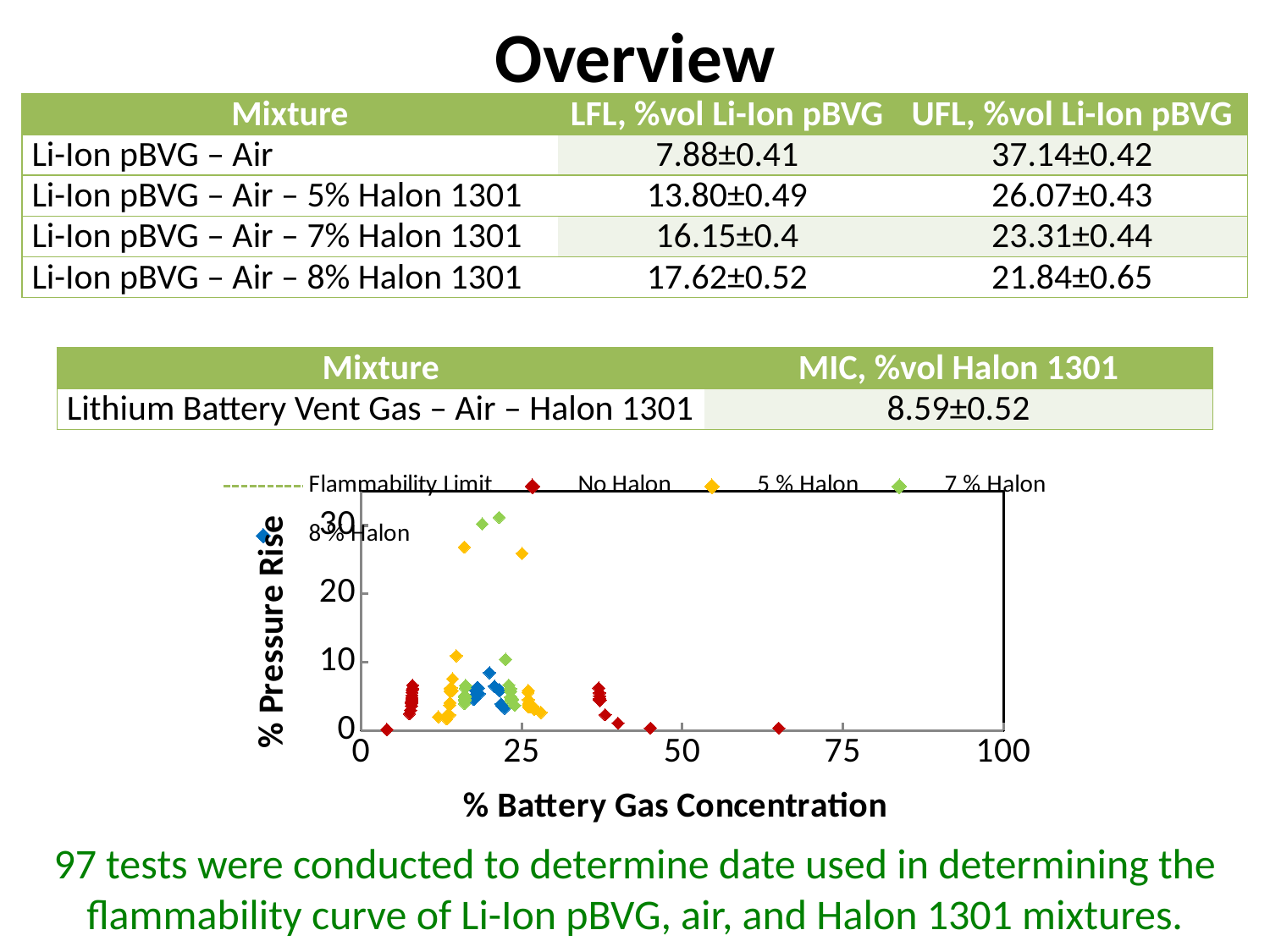
Is the highest % Pressure Rise value for the 8% Halon series greater or less than 10? less What is the title of the x axis of the chart? % Battery Gas Concentration Is the largest % Battery Gas Concentration value for the No Halon series greater or less than 50? greater How many series does the chart legend list? 5 Is the highest % Pressure Rise value for the 5 % Halon series greater or less than 20? greater What kind of chart is shown on the slide? scatter chart What is the title of the y axis of the chart? % Pressure Rise